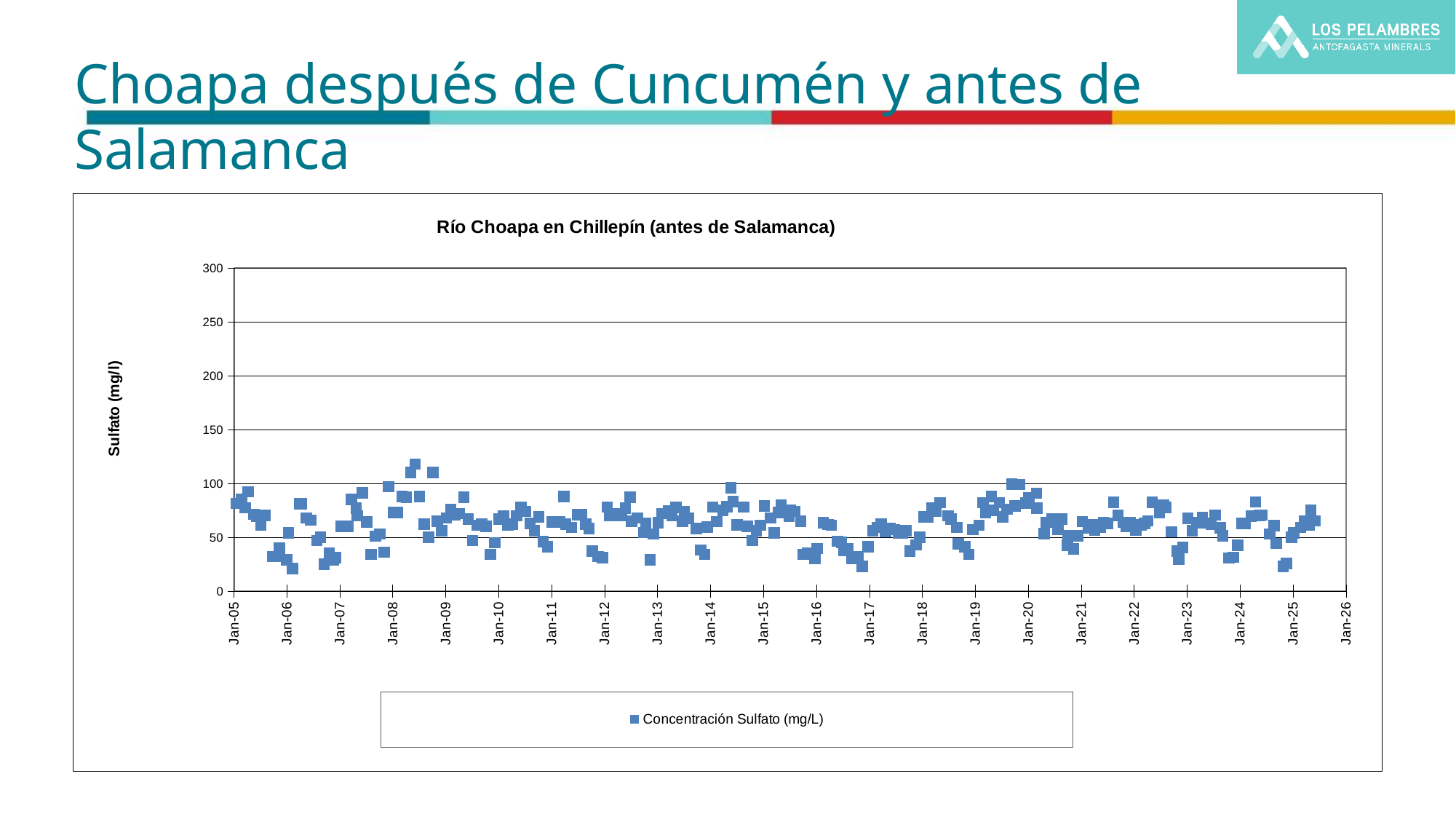
What is the maximum value shown on the y axis? 300 Are any of the plotted values greater than 200? No What is the first date label on the x axis? Jan-05 Is the highest plotted sulfate value greater or less than 150? less What is the label of the y axis? Sulfato (mg/l) What is the name of the series shown in the legend? Concentración Sulfato (mg/L) How many series does the legend list? 1 Is the highest plotted sulfate value greater or less than 100? greater What kind of chart is shown on the slide? scatter chart What is the last date label on the x axis? Jan-26 What is the title of the chart? Río Choapa en Chillepín (antes de Salamanca)